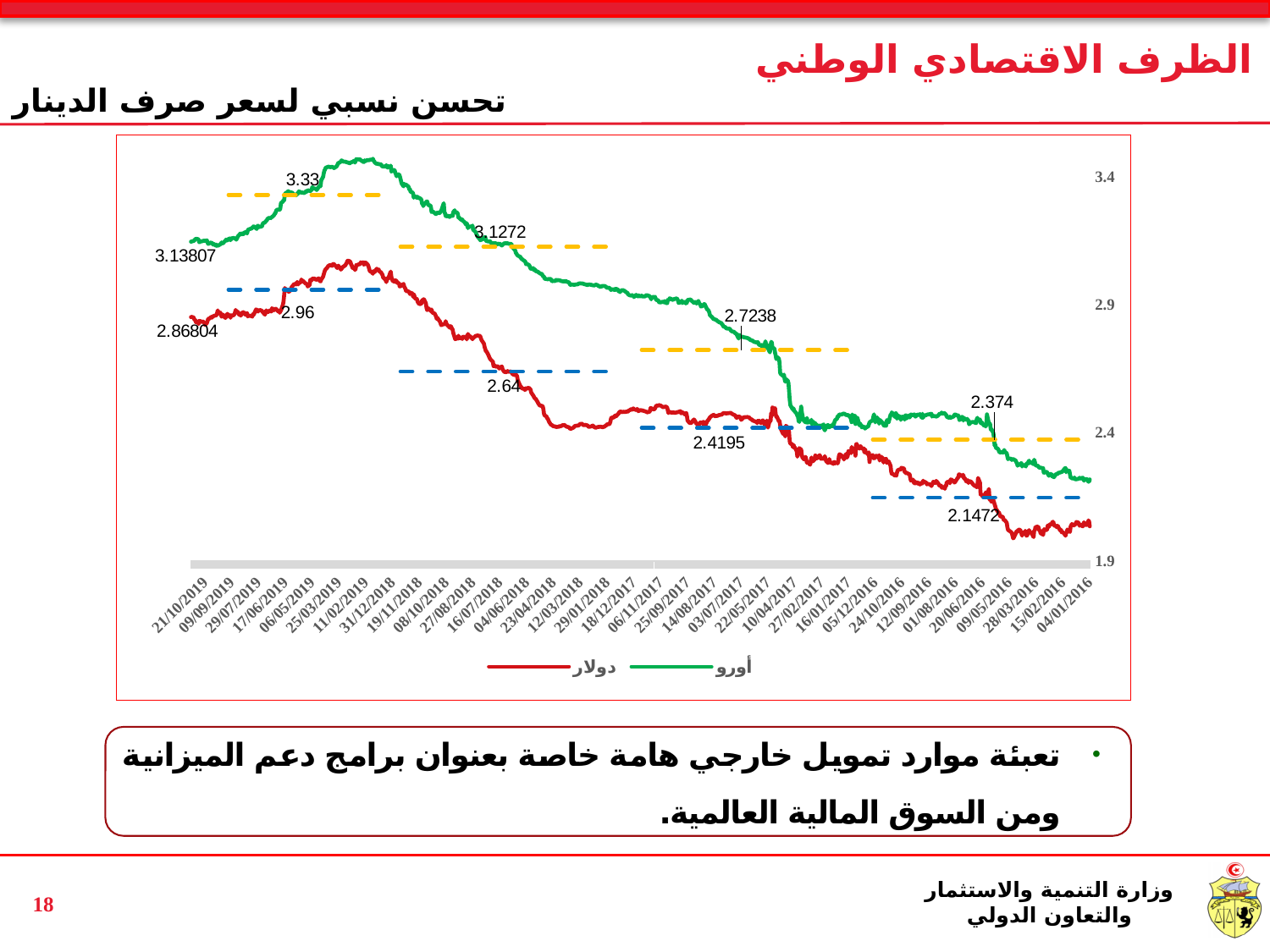
What type of chart is shown on the slide? line chart Do the exchange rate values rise or fall from 04/01/2016 to 21/10/2019? rise What value is labelled at the left end (21/10/2019) of the green أورو line? 3.13807 What value is labelled at the left end (21/10/2019) of the red دولار line? 2.86804 What is the highest value labelled on the green أورو line? 3.33 What is the difference between the 3.33 label on the أورو line and the 2.96 label on the دولار line? 0.37 Which line lies higher across the whole chart, أورو or دولار? أورو How many series does the chart legend list? 2 What are the two series named in the chart legend? أورو and دولار What is the difference between the 2.374 label on the أورو line and the 2.1472 label on the دولار line? 0.2268 What is the lowest value labelled on the red دولار line? 2.1472 Is the value of the دولار line at 04/01/2016 greater or less than 2.4? less